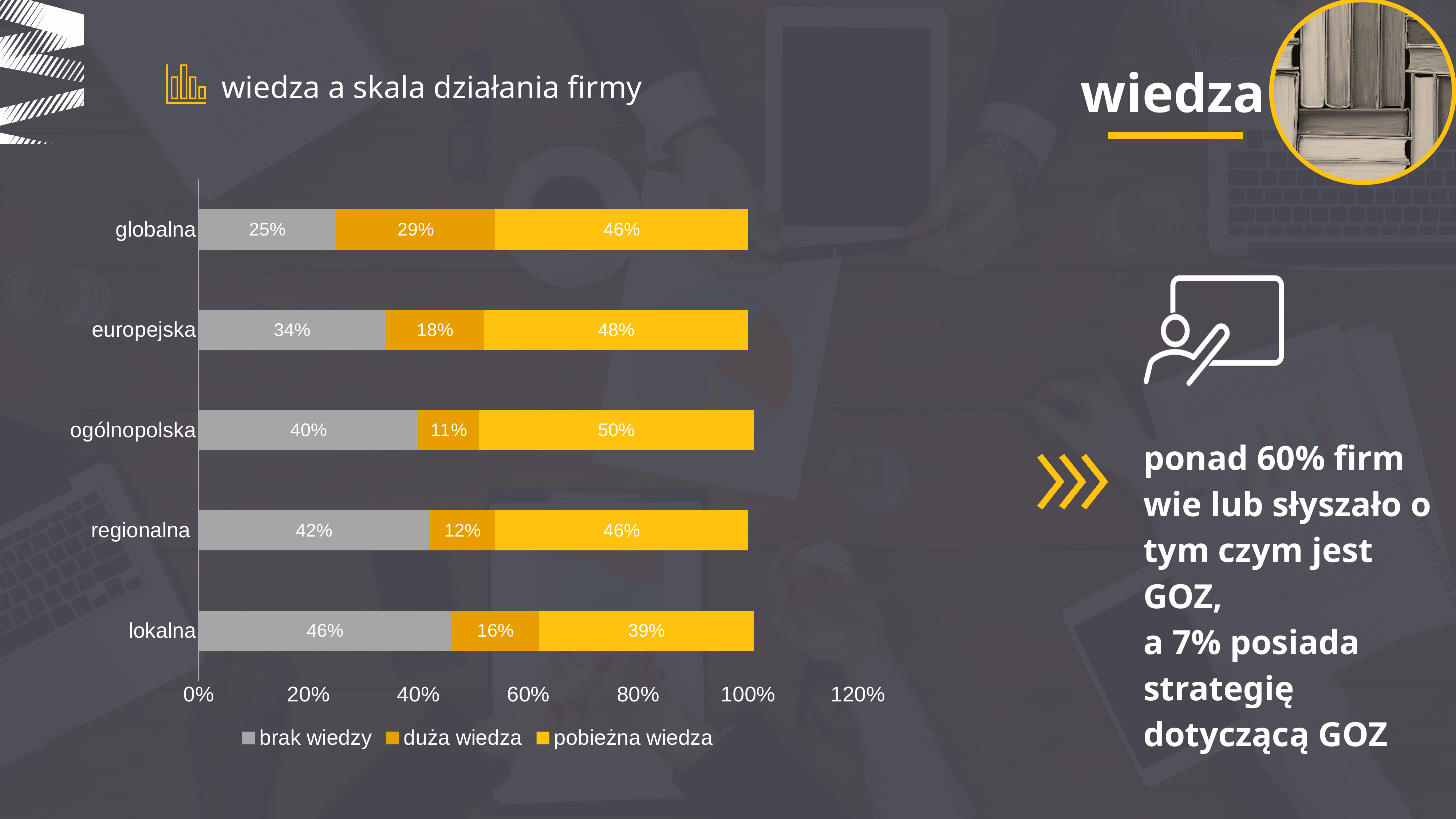
What is the value of 'pobieżna wiedza' for 'ogólnopolska'? 50% Which category has the lowest value for 'brak wiedzy'? globalna Which category has the highest value for 'duża wiedza'? globalna What is the value of 'duża wiedza' for 'europejska'? 18% What kind of chart is shown on the slide? stacked bar chart What is the value of 'brak wiedzy' for 'lokalna'? 46% What is the difference between 'brak wiedzy' for 'lokalna' and 'brak wiedzy' for 'globalna'? 21% What is the title of the chart? wiedza a skala działania firmy Which is larger: 'pobieżna wiedza' for 'europejska' or 'pobieżna wiedza' for 'lokalna'? europejska How many categories are shown on the y axis of the chart? 5 What is the value of 'brak wiedzy' for 'globalna'? 25% How many series does the legend list? 3